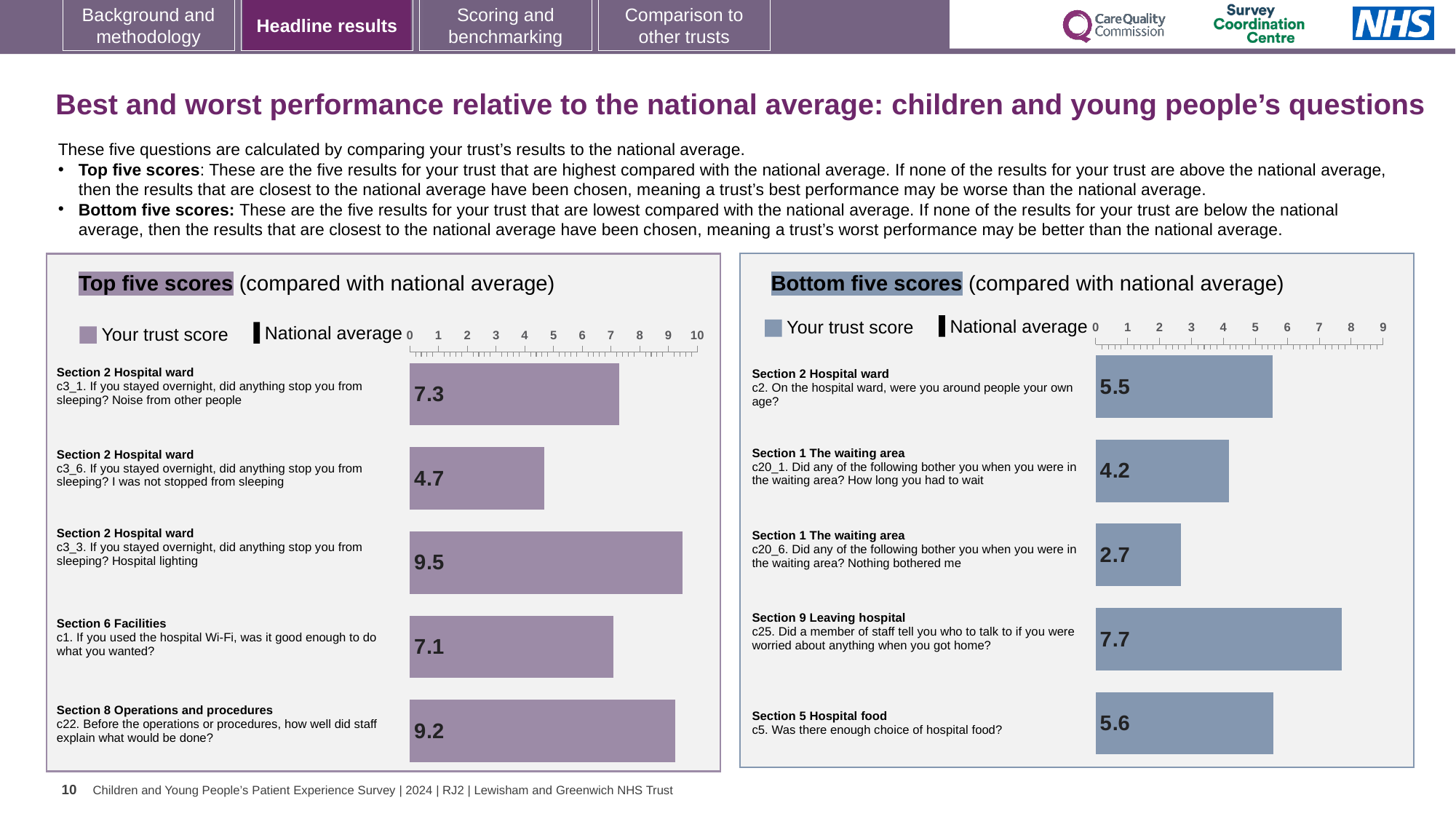
How many questions are plotted in the Bottom five scores chart? 5 In the Bottom five scores chart, what is the trust score for c25 (staff told you who to talk to if worried when you got home)? 7.7 In the Bottom five scores chart, what is the difference between the trust scores for c5 (5.6) and c20_1 (4.2)? 1.4 In the Top five scores chart, what is the trust score for c1 (hospital Wi-Fi)? 7.1 In the Bottom five scores chart, is the trust score for c2 (around people your own age) greater or less than 5? greater In the Top five scores chart, which question has the lowest trust score? c3_6. If you stayed overnight, did anything stop you from sleeping? I was not stopped from sleeping What type of chart is used in the Top five scores panel? Bar chart In the Top five scores chart, what is the difference between the trust scores for c3_3 (9.5) and c3_1 (7.3)? 2.2 In the Bottom five scores chart, which question has the highest trust score? c25. Did a member of staff tell you who to talk to if you were worried about anything when you got home? In the Top five scores chart, what is the trust score for c3_3 (Hospital lighting)? 9.5 In the Top five scores chart, which has the larger trust score: c22 (explaining operations) or c1 (hospital Wi-Fi)? c22 In the Bottom five scores chart, what is the trust score for c20_6 (Nothing bothered me in the waiting area)? 2.7